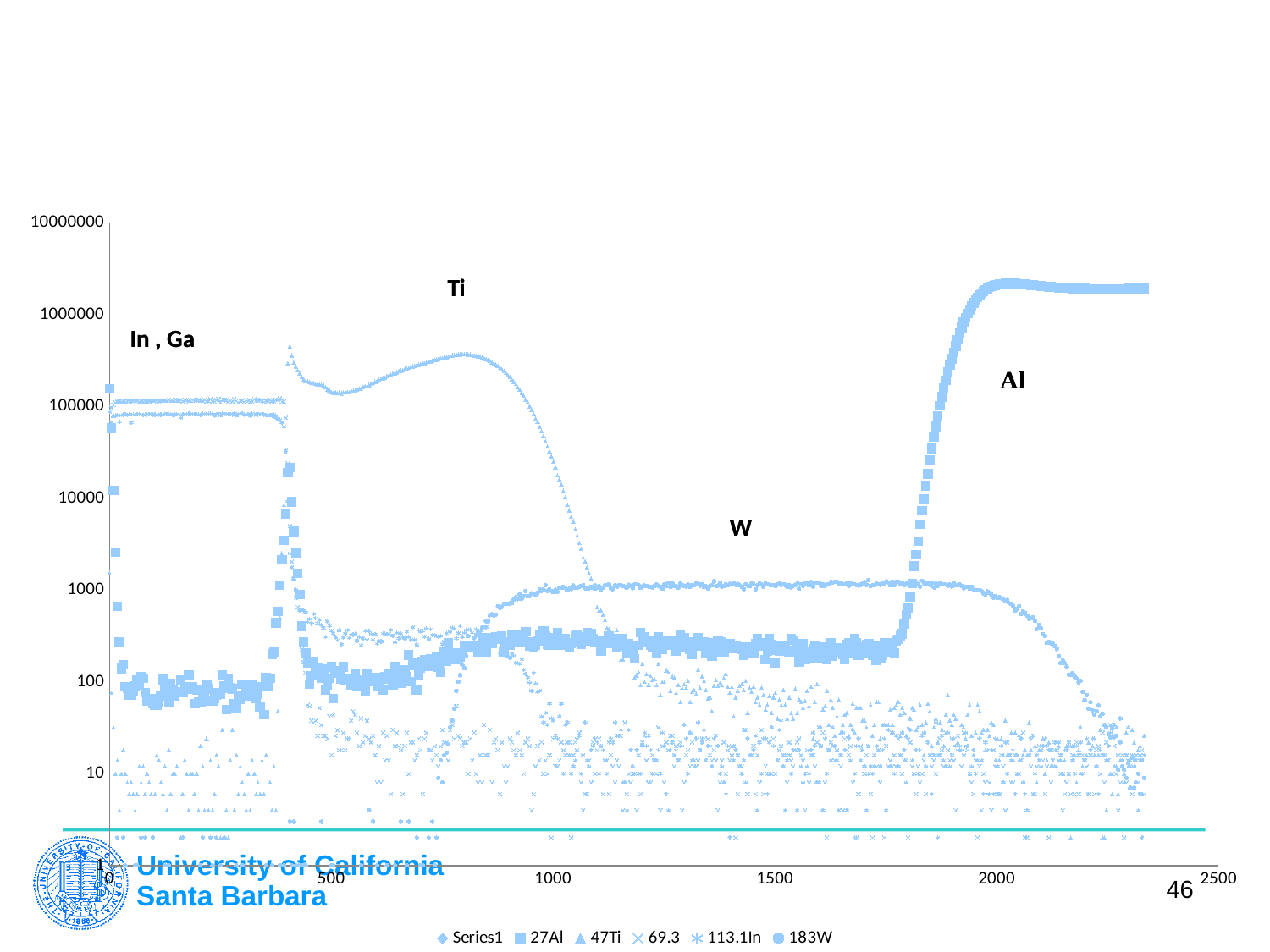
Is the peak value of the Ti curve near x = 800 greater or less than 1000000? less How many series does the legend list? 6 What kind of chart is shown on the slide? scatter chart Does the Ti series rise or fall between x = 800 and x = 1100? fall Is the value of the W plateau at x = 1500 greater or less than 10000? less Is the value of the In, Ga plateau at x = 200 greater or less than 10000? greater What is the highest tick value shown on the y axis? 10000000 What is the last entry in the chart's legend? 183W Which element label is placed near the top-right plateau of the chart? Al Does the Al series rise or fall between x = 1800 and x = 2000? rise